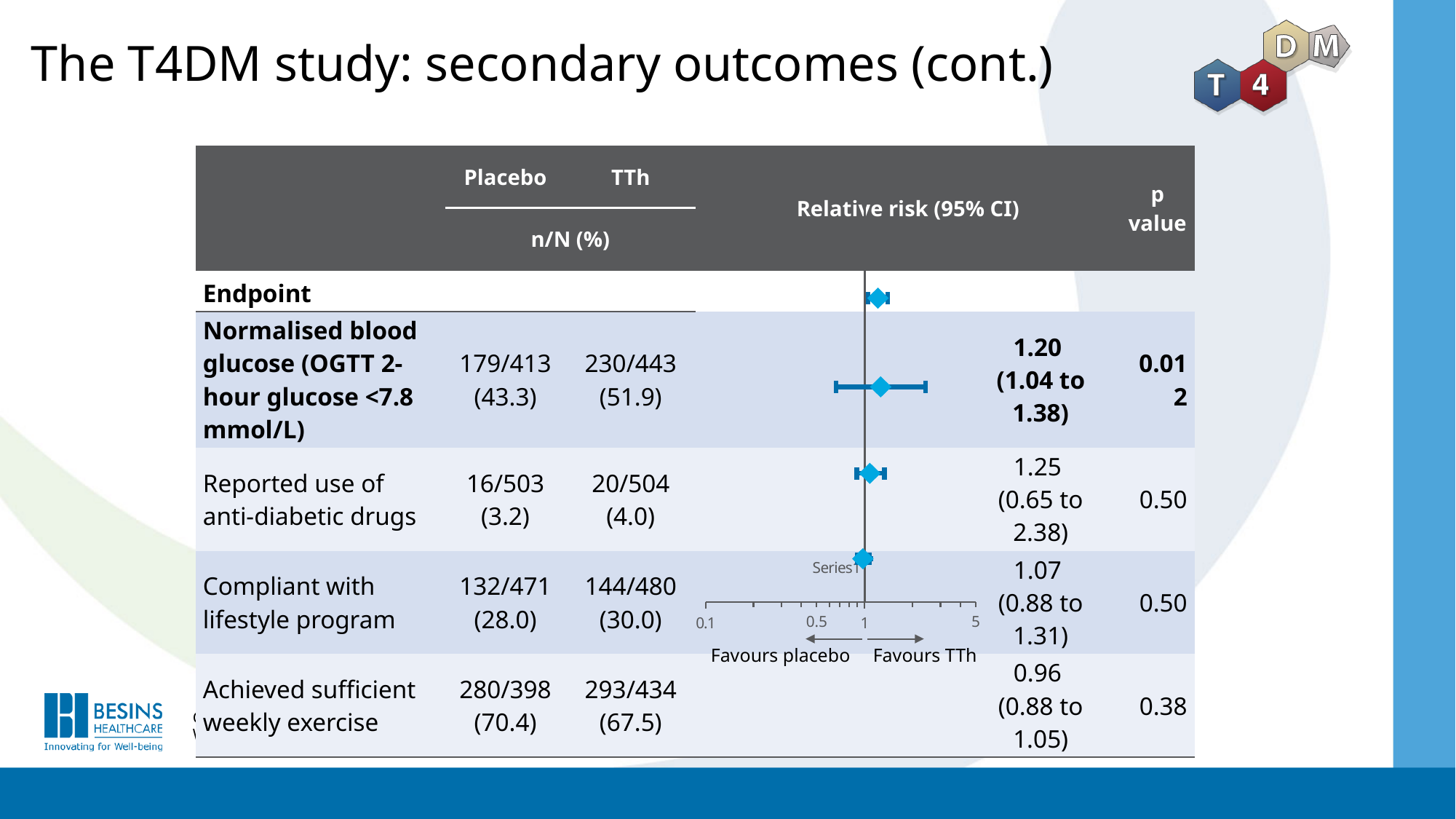
Which has the larger relative risk: normalised blood glucose or compliant with lifestyle program? Normalised blood glucose What is the difference between the relative risk for reported use of anti-diabetic drugs and for achieved sufficient weekly exercise? 0.29 How many series does the chart legend list? 1 Which endpoint has the highest relative risk point estimate? Reported use of anti-diabetic drugs What kind of chart is shown alongside the table on the slide? Forest plot Which endpoint has the lowest relative risk point estimate? Achieved sufficient weekly exercise What is the relative risk for reported use of anti-diabetic drugs? 1.25 What is the relative risk for compliant with lifestyle program? 1.07 What is the relative risk (95% CI) for achieved sufficient weekly exercise? 0.96 (0.88 to 1.05) What are the tick labels shown on the x axis of the forest plot? 0.1, 0.5, 1, 5 What is the relative risk (95% CI) for normalised blood glucose (OGTT 2-hour glucose <7.8 mmol/L)? 1.20 (1.04 to 1.38)